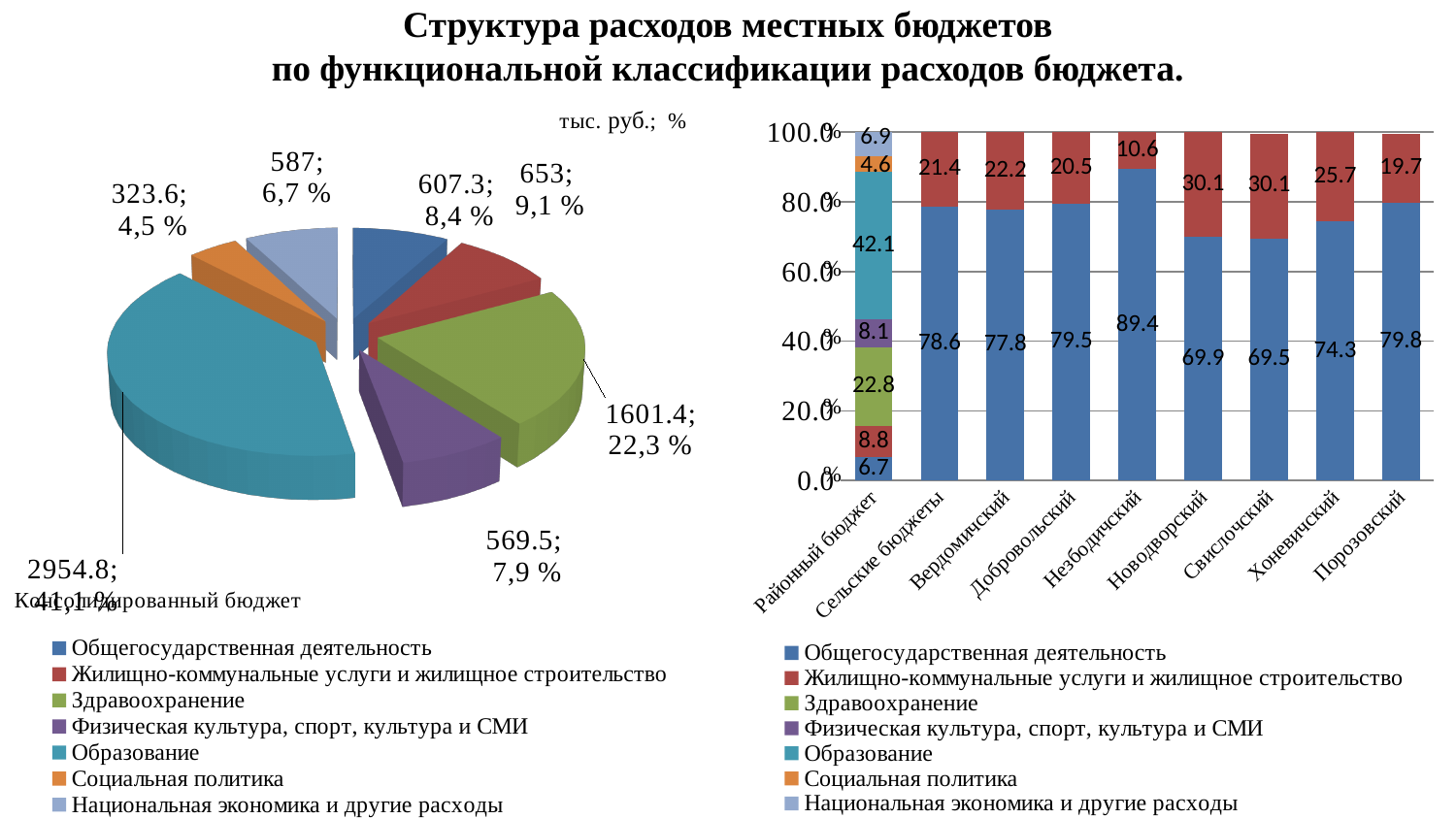
In the stacked bar chart on the right, what is the value of the red segment (Жилищно-коммунальные услуги) for Новодворский? 30.1 In the stacked bar chart on the right, what is the value of the teal segment (Образование) for Районный бюджет? 42.1 What kind of chart is shown on the right side of the slide? Stacked bar chart In the pie chart on the left, which category has the smallest slice? Социальная политика In the stacked bar chart on the right, how many categories are shown on the x axis? 9 How many series does the legend of the stacked bar chart on the right list? 7 In the pie chart on the left, what is the difference in тыс. руб. between Образование (2954.8) and Здравоохранение (1601.4)? 1353.4 In the stacked bar chart on the right, which category has the highest value for the blue segment (Общегосударственная деятельность)? Незбодичский In the pie chart on the left, what value in тыс. руб. is shown for Здравоохранение? 1601.4 In the pie chart on the left, what share does Образование (the largest slice) have? 41,1 % In the stacked bar chart on the right, which is larger: the blue segment for Порозовский or the blue segment for Свислочский? Порозовский In the stacked bar chart on the right, what is the value of the blue segment (Общегосударственная деятельность) for Незбодичский? 89.4